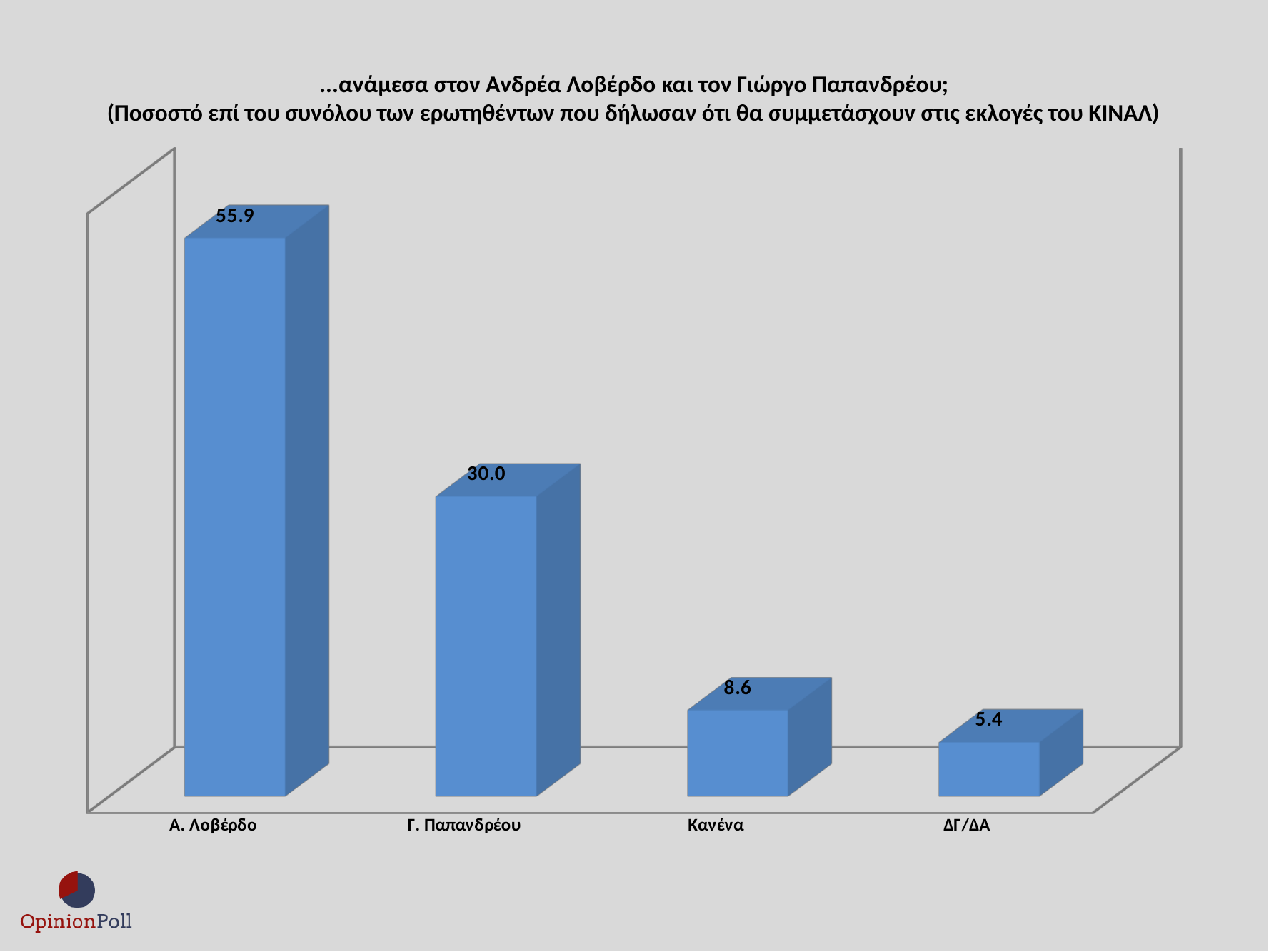
Do the values rise or fall from left to right along the x axis? Fall What is the value for ΔΓ/ΔΑ? 5.4 What is the value for Γ. Παπανδρέου? 30.0 What is the difference between the values for Α. Λοβέρδο and Γ. Παπανδρέου? 25.9 How many categories are shown in the chart? 4 What is the value for Κανένα? 8.6 Which category has the highest value? Α. Λοβέρδο Which category has the lowest value? ΔΓ/ΔΑ Which is larger, the value for Γ. Παπανδρέου or the value for Κανένα? Γ. Παπανδρέου What is the value for Α. Λοβέρδο? 55.9 What is the difference between the values for Κανένα and ΔΓ/ΔΑ? 3.2 What kind of chart is shown on the slide? Bar chart